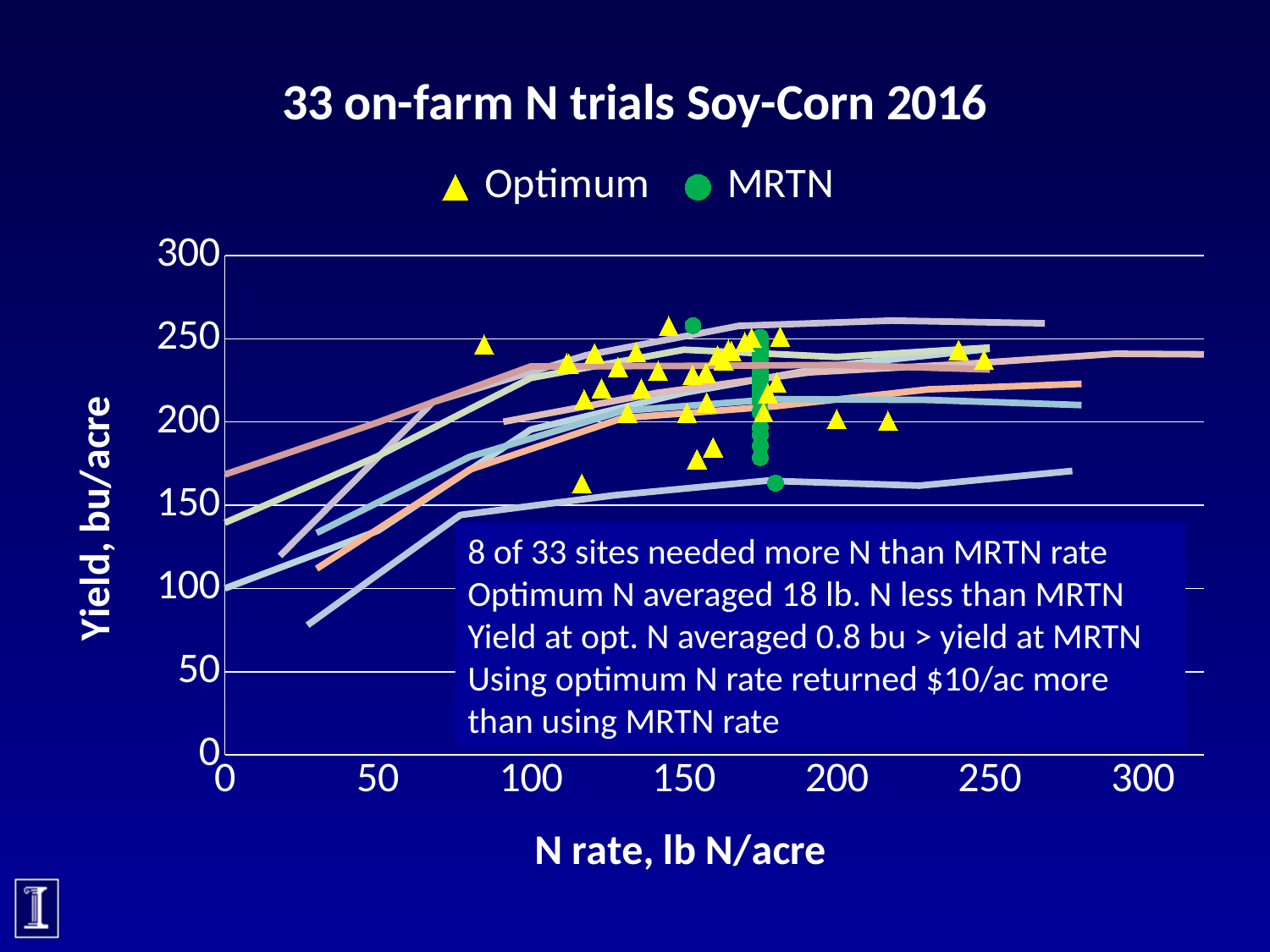
Is the yield of the highest MRTN point (green circle near 155 lb N/acre) greater or less than 250 bu/acre? greater What are the two series named in the chart legend? Optimum and MRTN According to the text box on the chart, how much more per acre did using the optimum N rate return than using the MRTN rate? $10/ac According to the text box on the chart, how many of the 33 sites needed more N than the MRTN rate? 8 What is the highest value shown on the y axis? 300 What is the label of the y axis? Yield, bu/acre Is the yield of the lowest Optimum triangle (near 120 lb N/acre) greater or less than 200 bu/acre? less What is the label of the x axis? N rate, lb N/acre How many series does the chart legend list? 2 Is the yield of the lowest MRTN point (green circle near 180 lb N/acre) greater or less than 200 bu/acre? less What is the title of the chart? 33 on-farm N trials Soy-Corn 2016 Do the plotted yield response curves generally rise or fall as N rate increases? rise